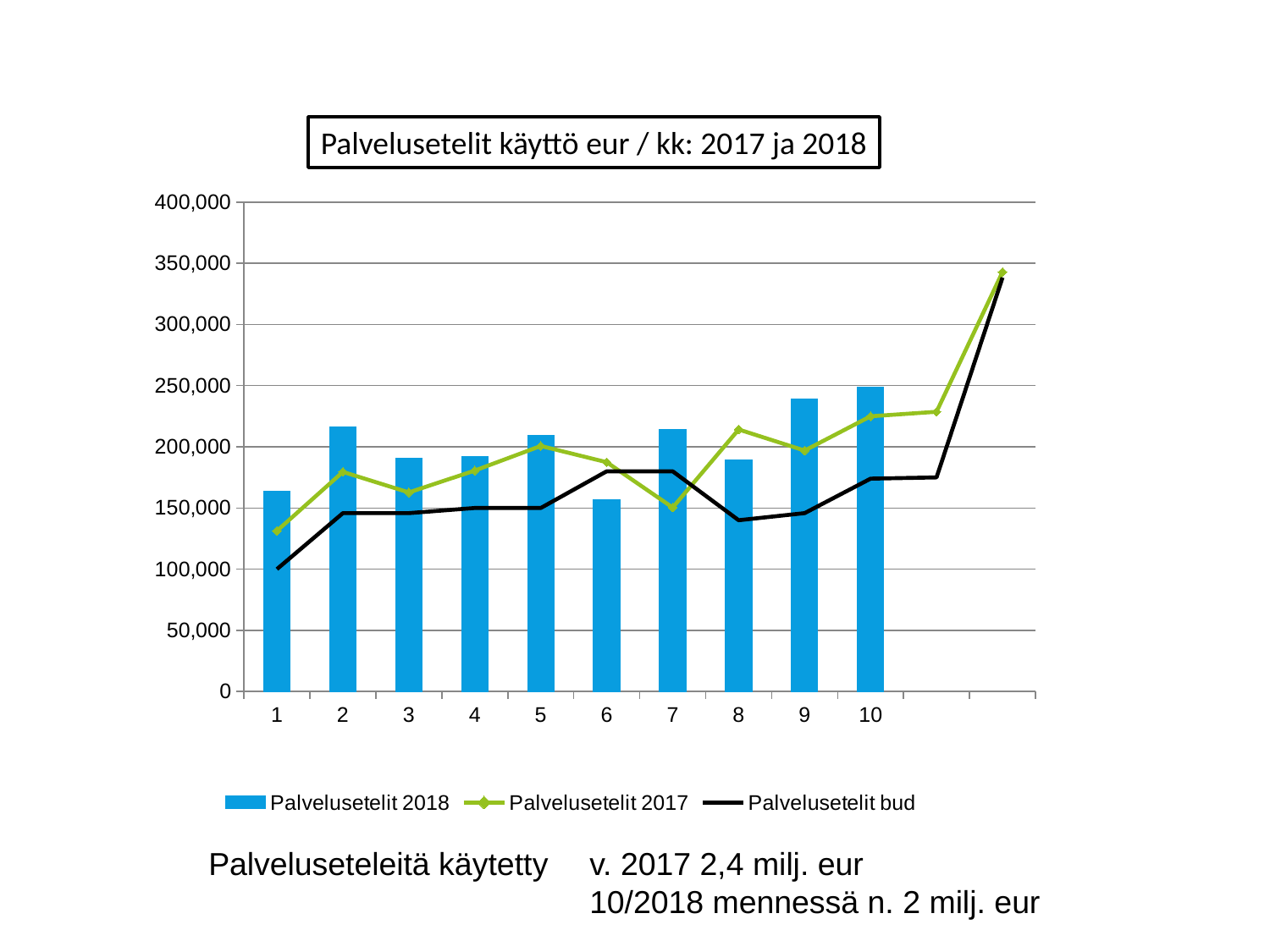
Which month has the tallest Palvelusetelit 2018 bar? 10 Is the Palvelusetelit 2018 bar for month 6 greater or less than 200,000? less In which month is the Palvelusetelit 2017 line at its lowest value? 1 How many series does the legend list? 3 Is the Palvelusetelit 2017 value for the last month greater or less than 300,000? greater Is the Palvelusetelit 2018 bar for month 10 greater or less than 200,000? greater In month 2, which is larger: the Palvelusetelit 2018 bar or the Palvelusetelit 2017 line? Palvelusetelit 2018 In month 6, which is larger: the Palvelusetelit 2018 bar or the Palvelusetelit 2017 line? Palvelusetelit 2017 What is the title of the chart? Palvelusetelit käyttö eur / kk: 2017 ja 2018 How many months have a bar for Palvelusetelit 2018? 10 In which month does the Palvelusetelit 2017 line reach its highest value? 12 What kind of chart is shown on the slide? A combined bar and line chart